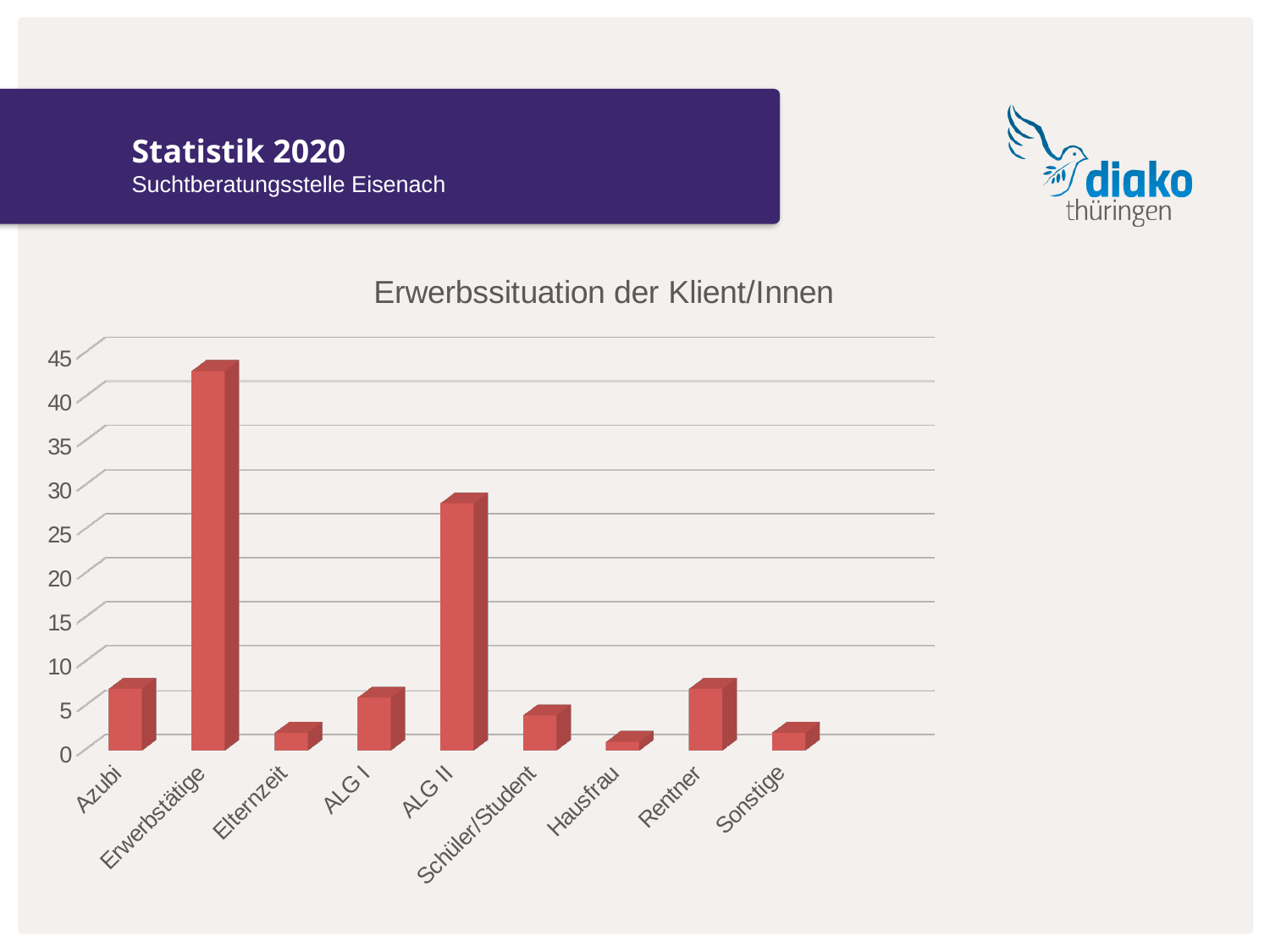
Is the value for Azubi greater or less than 10? less Which is larger, the value for ALG II or the value for Rentner? ALG II Is the value for Rentner greater or less than 10? less Is the value for Erwerbstätige greater or less than 40? greater Which category has the highest value in the chart? Erwerbstätige How many categories are shown on the x axis of the chart? 9 Which is larger, the value for Erwerbstätige or the value for ALG II? Erwerbstätige What type of chart is shown on the slide? Bar chart Which is larger, the value for Azubi or the value for Elternzeit? Azubi What is the title of the chart? Erwerbssituation der Klient/Innen